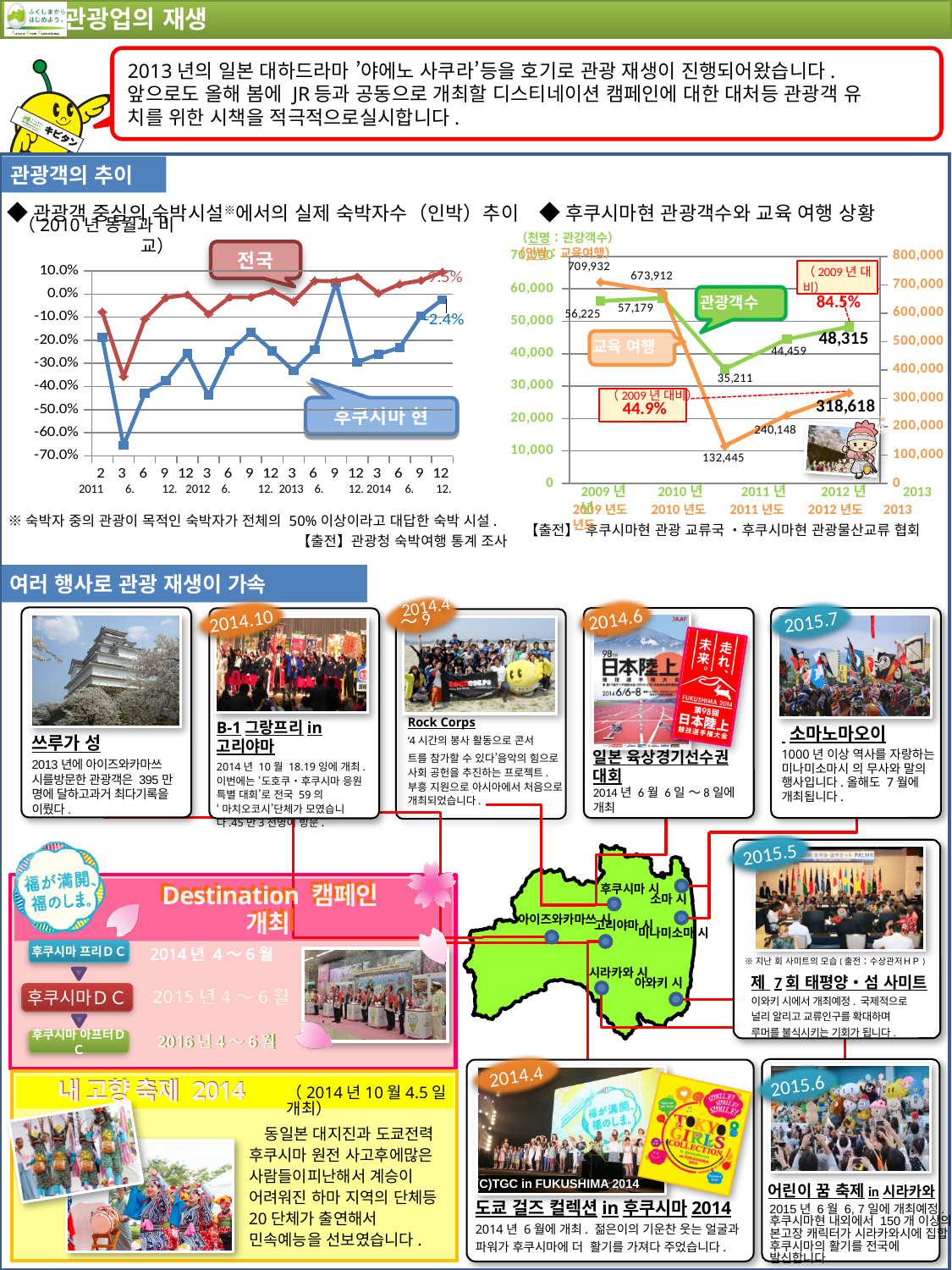
What kind of chart is the right chart (후쿠시마현 관광객수와 교육 여행 상황)? Line chart In the right chart (후쿠시마현 관광객수와 교육 여행 상황), what is the 관광객 value for 2013? 48,315 In the right chart (후쿠시마현 관광객수와 교육 여행 상황), what is the 관광객 value for 2009년? 56,225 In the right chart (후쿠시마현 관광객수와 교육 여행 상황), which is larger, the 교육 여행 value for 2012년 or for 2013? 2013 In the right chart (후쿠시마현 관광객수와 교육 여행 상황), what is the 교육 여행 value for 2011년? 132,445 In the right chart (후쿠시마현 관광객수와 교육 여행 상황), what is the difference between the 관광객 values for 2010년 and 2011년? 21,968 In the left chart (숙박자수 추이), what is the final labelled value for 전국? 9.5% In the right chart (후쿠시마현 관광객수와 교육 여행 상황), what is the difference between the 교육 여행 values for 2012년 and 2011년? 107,703 In the left chart (숙박자수 추이), what is the final labelled value for 후쿠시마 현? -2.4% In the right chart (후쿠시마현 관광객수와 교육 여행 상황), how many series are plotted? 2 In the right chart (후쿠시마현 관광객수와 교육 여행 상황), which year has the lowest 관광객 value? 2011년 In the right chart (후쿠시마현 관광객수와 교육 여행 상황), which year has the highest 교육 여행 value? 2009년